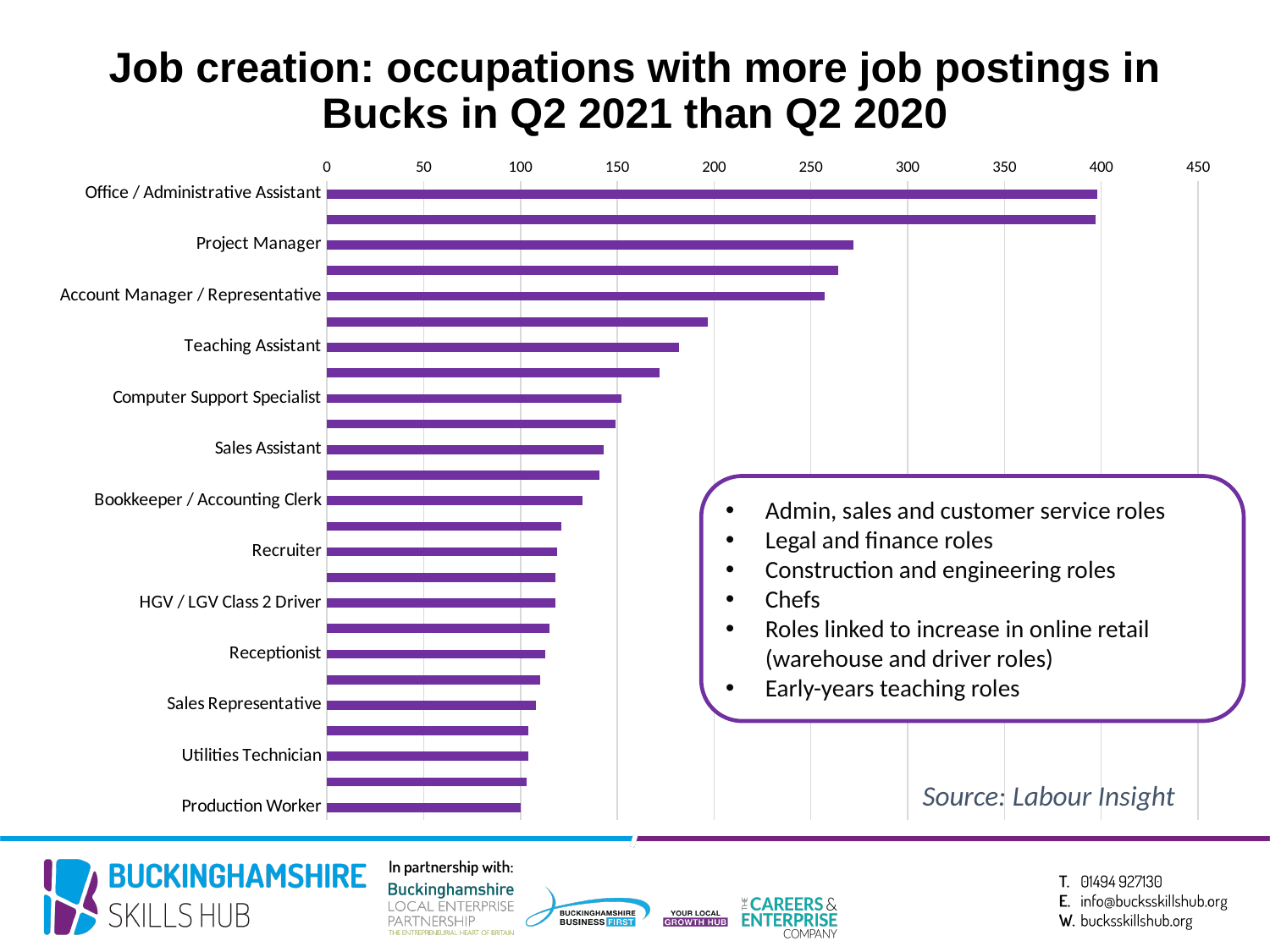
What kind of chart is shown on the slide? Bar chart Is the value for Teaching Assistant greater or less than 200? less Which is larger, the value for Project Manager or the value for Computer Support Specialist? Project Manager Do the bar values increase or decrease going from the top of the chart to the bottom? Decrease Is the value for Bookkeeper / Accounting Clerk greater or less than 150? less Is the value for Project Manager greater or less than 250? greater Which occupation has the highest number of job postings in the chart? Office / Administrative Assistant What is the highest value shown on the horizontal axis? 450 What source is cited for the chart data? Labour Insight